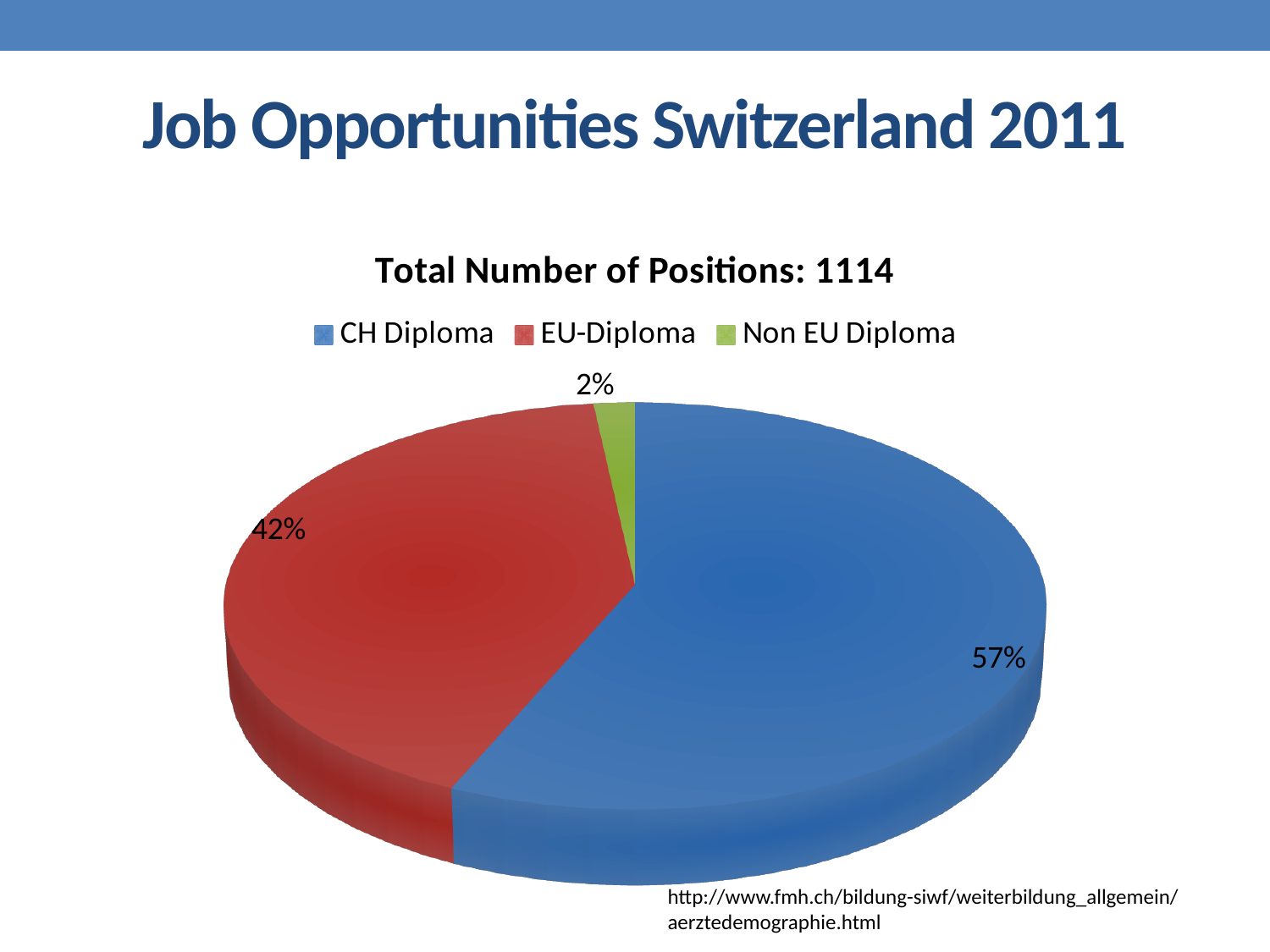
How many categories does the pie chart have? 3 What is the title of the chart? Total Number of Positions: 1114 Which category has the largest share of the pie? CH Diploma What is the difference in percentage points between the CH Diploma and EU-Diploma shares? 15 What share of positions is held by EU-Diploma? 42% What share of positions is held by CH Diploma? 57% Which category has the smallest share of the pie? Non EU Diploma What colour is the EU-Diploma slice? red What share of positions is held by Non EU Diploma? 2% How many entries does the legend list? 3 Which is larger, the EU-Diploma share or the Non EU Diploma share? EU-Diploma What kind of chart is shown on the slide? pie chart